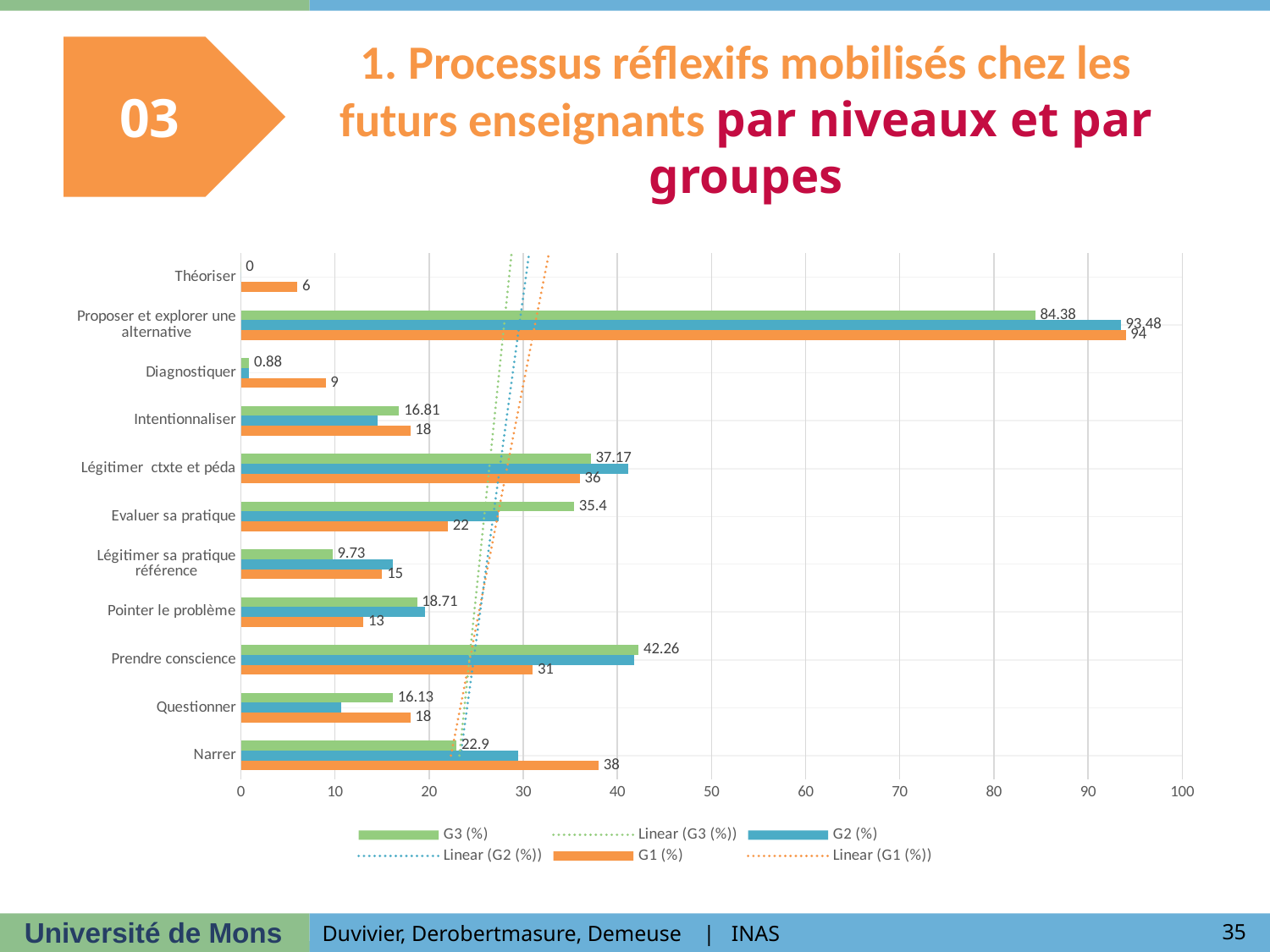
What kind of chart is shown on the slide? bar chart What is the difference between the G1 (%) values for Narrer and Questionner? 20 What is the G1 (%) value for Narrer? 38 Which category has the lowest G3 (%) value? Théoriser How many categories are shown on the vertical axis of the chart? 11 What is the difference between the G1 (%) and G3 (%) values for Proposer et explorer une alternative? 9.62 Which category has the highest G1 (%) value? Proposer et explorer une alternative How many entries does the chart legend list? 6 What is the G2 (%) value for Proposer et explorer une alternative? 93.48 Is the G2 (%) value for Narrer greater or less than 20? greater What is the G3 (%) value for Prendre conscience? 42.26 For Evaluer sa pratique, which is larger: the G3 (%) value or the G1 (%) value? G3 (%)